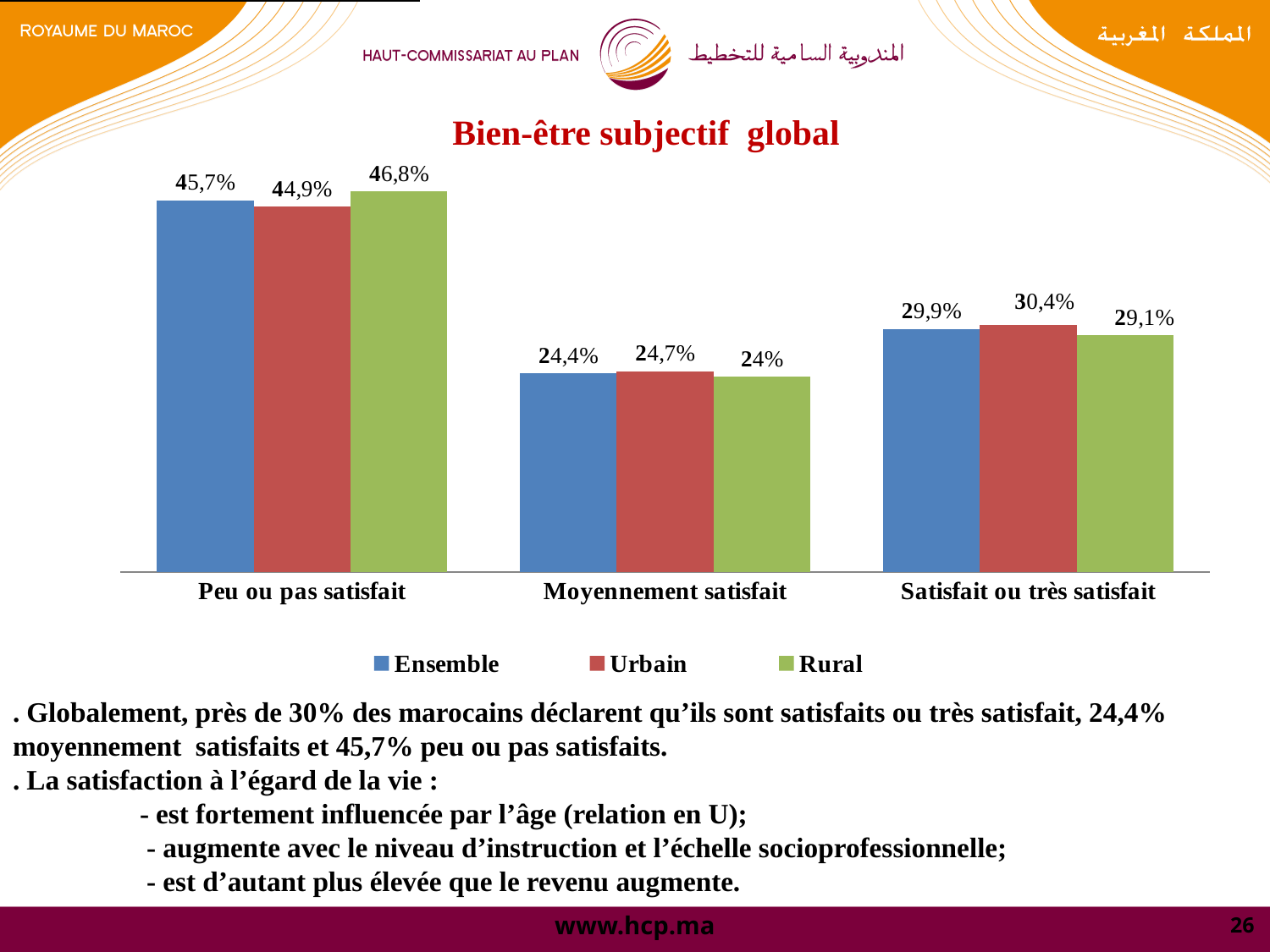
How many series does the legend list? 3 What is the difference between the Rural and Urbain values in the 'Peu ou pas satisfait' category? 1,9% What is the value for Urbain in the 'Satisfait ou très satisfait' category? 30,4% What is the value for Ensemble in the 'Peu ou pas satisfait' category? 45,7% In the 'Satisfait ou très satisfait' category, which is larger: the Urbain value or the Rural value? Urbain What is the value for Urbain in the 'Moyennement satisfait' category? 24,7% What is the difference between the Urbain and Rural values in the 'Satisfait ou très satisfait' category? 1,3% What is the value for Rural in the 'Peu ou pas satisfait' category? 46,8% Which category has the highest value for the Ensemble series? Peu ou pas satisfait How many categories are shown on the x axis? 3 Which category has the lowest value for the Rural series? Moyennement satisfait What kind of chart is shown on the slide? Bar chart